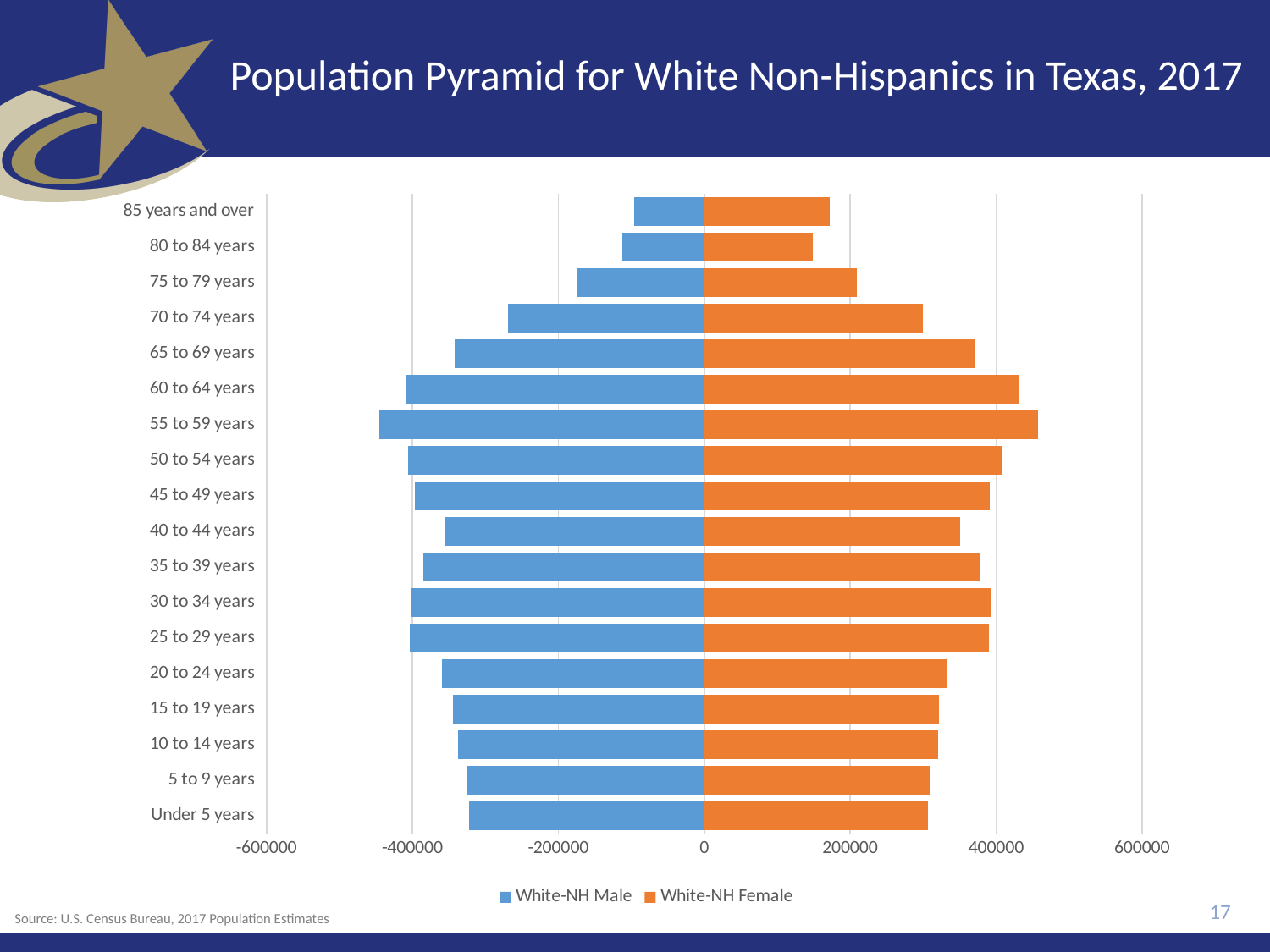
Is the White-NH Female value for 85 years and over greater or less than 200000? less Which is larger, the White-NH Female value for 55 to 59 years or for 85 years and over? 55 to 59 years Which age group has the longest White-NH Female bar? 55 to 59 years What colour represents White-NH Male in the chart? Blue How many age groups are plotted on the chart? 18 Which age group has the shortest White-NH Female bar? 80 to 84 years How many series does the legend list? 2 Is the White-NH Female value for 55 to 59 years greater or less than 400000? greater Do the White-NH Female bars generally get shorter moving from 55 to 59 years up to 85 years and over? Yes Does the White-NH Male bar for 55 to 59 years extend beyond the -400000 gridline? Yes What kind of chart is shown on the slide? Bar chart